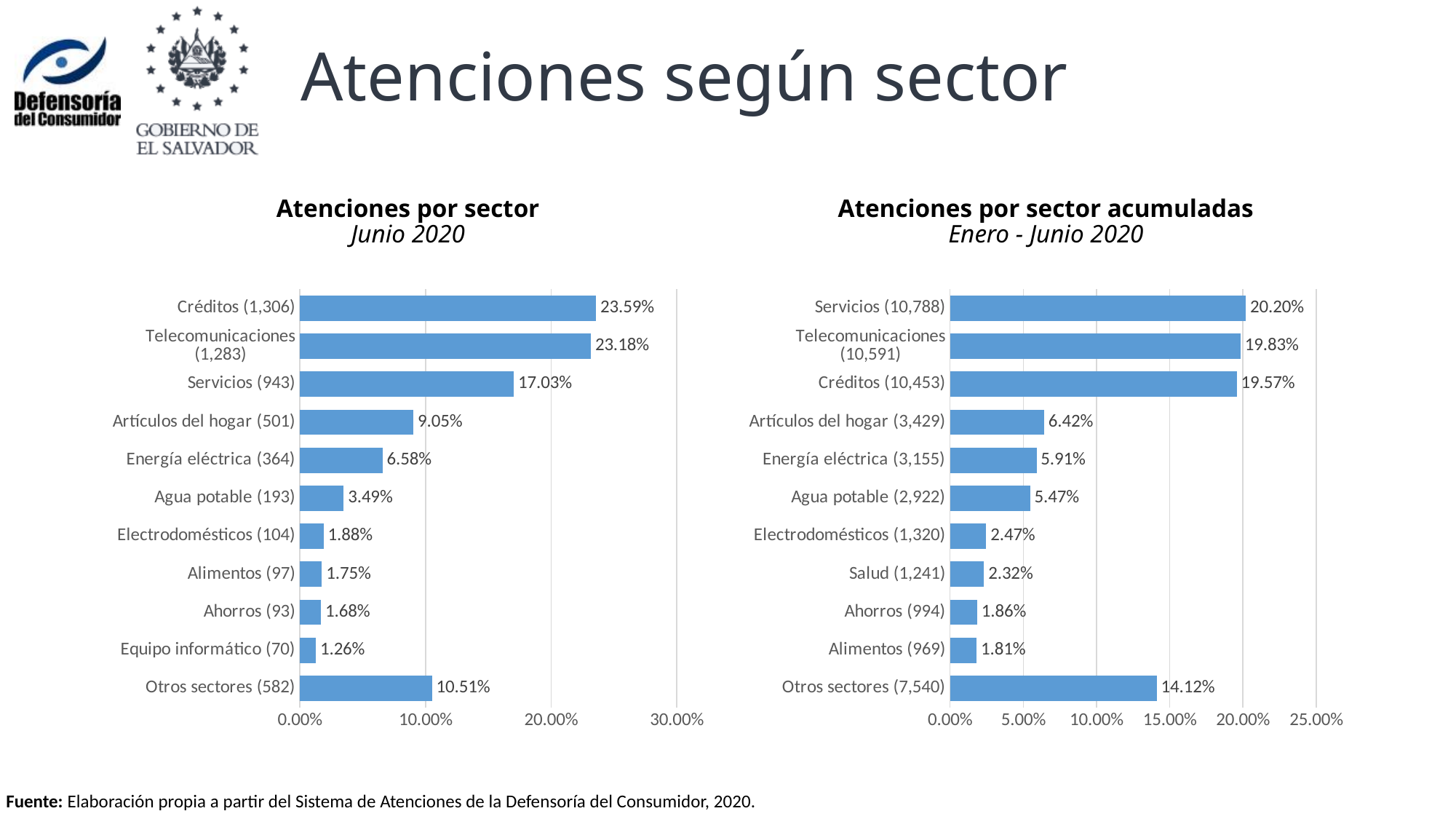
In the 'Atenciones por sector Junio 2020' chart, is the value for Otros sectores (582) greater or less than 10.00%? greater In the 'Atenciones por sector acumuladas Enero - Junio 2020' chart, which category has the lowest value? Alimentos (969) How many categories are shown in the 'Atenciones por sector acumuladas Enero - Junio 2020' chart? 11 In the 'Atenciones por sector acumuladas Enero - Junio 2020' chart, what is the difference between the values for Servicios (10,788) and Créditos (10,453)? 0.63% In the 'Atenciones por sector Junio 2020' chart, what is the value for Equipo informático (70)? 1.26% In the 'Atenciones por sector Junio 2020' chart, what is the value for Créditos (1,306)? 23.59% What kind of chart is the 'Atenciones por sector Junio 2020' chart? bar chart In the 'Atenciones por sector Junio 2020' chart, what is the difference between the values for Servicios (943) and Artículos del hogar (501)? 7.98% What is the subtitle (period) shown under the title of the right-hand chart? Enero - Junio 2020 In the 'Atenciones por sector acumuladas Enero - Junio 2020' chart, which is larger: Electrodomésticos (1,320) or Salud (1,241)? Electrodomésticos (1,320) In the 'Atenciones por sector Junio 2020' chart, which category has the highest value? Créditos (1,306) In the 'Atenciones por sector acumuladas Enero - Junio 2020' chart, what is the value for Agua potable (2,922)? 5.47%